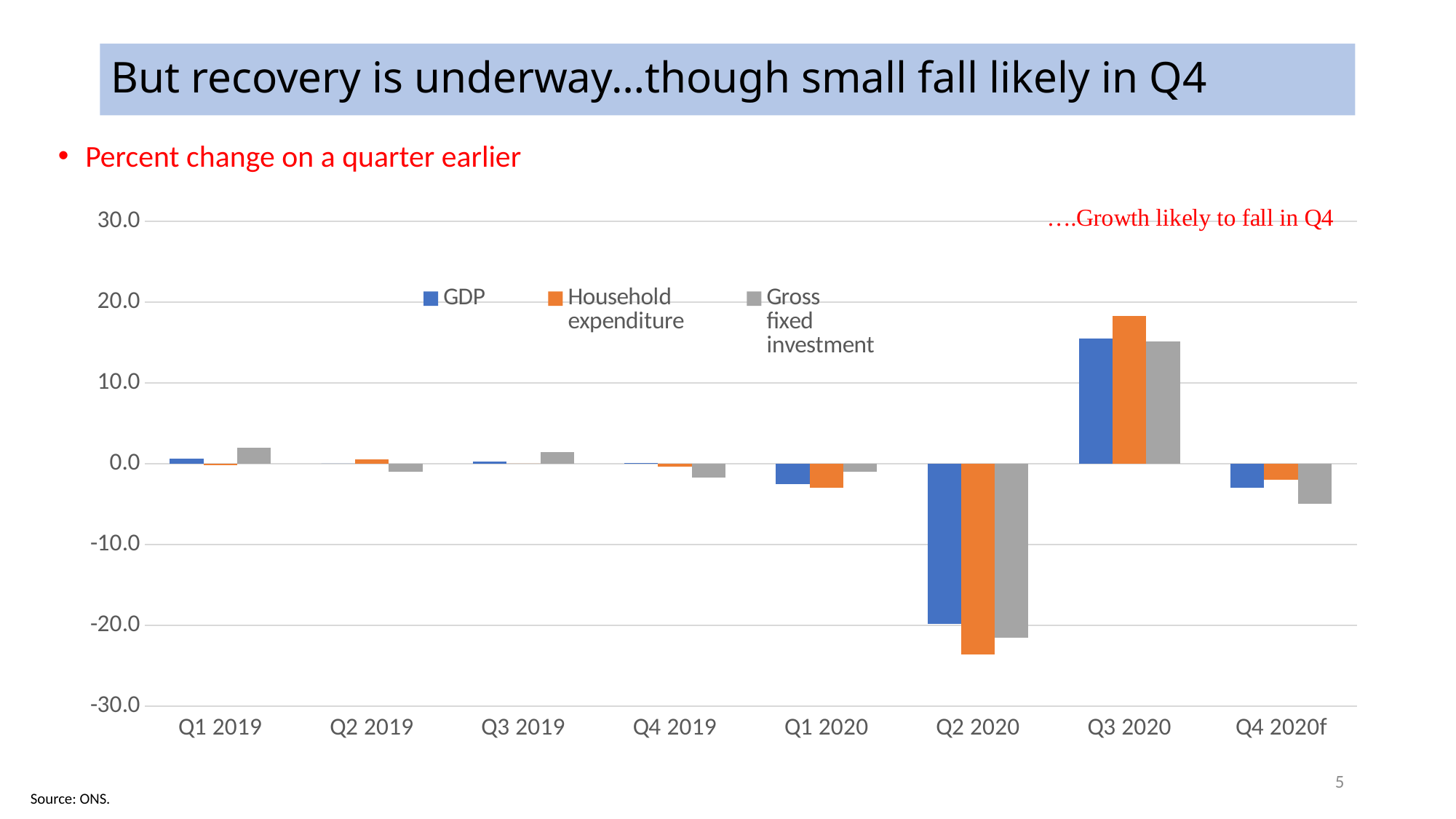
In which quarter is the GDP bar lowest? Q2 2020 How many quarters are shown along the x axis of the chart? 8 In Q3 2020, which is larger: GDP or Household expenditure? Household expenditure What source is cited for the chart? ONS How many series does the chart's legend list? 3 Is the value for Household expenditure in Q2 2020 greater or less than -20.0? less In Q2 2020, which fell more: GDP or Household expenditure? Household expenditure What kind of chart is shown on the slide? Bar chart What are the three series named in the chart's legend? GDP, Household expenditure, Gross fixed investment In which quarter is the Household expenditure bar highest? Q3 2020 Is the value for Gross fixed investment in Q4 2020f greater or less than -10.0? greater Is the value for GDP in Q3 2020 greater or less than 10.0? greater